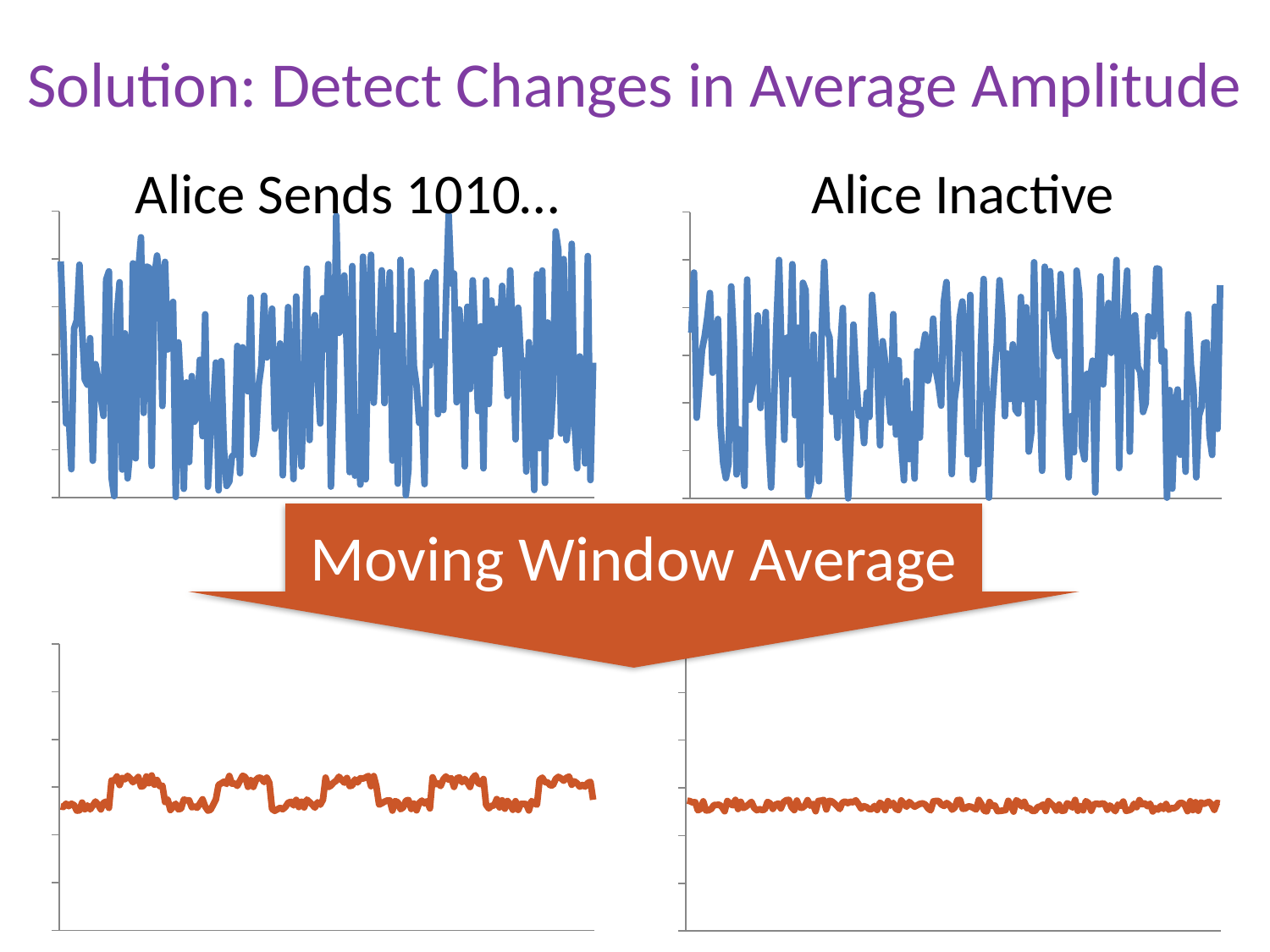
In the bottom-right chart, does the line rise, fall, or stay roughly flat along the x axis? stays roughly flat What kind of chart is the top-left chart titled "Alice Sends 1010…"? line chart What is the title of the top-right chart? Alice Inactive What kind of chart is the bottom-right chart? line chart How many charts are shown on the slide? 4 What colour is the line in the two bottom charts? orange In the bottom-left chart, how many raised pulses (high-level segments) does the line show? 5